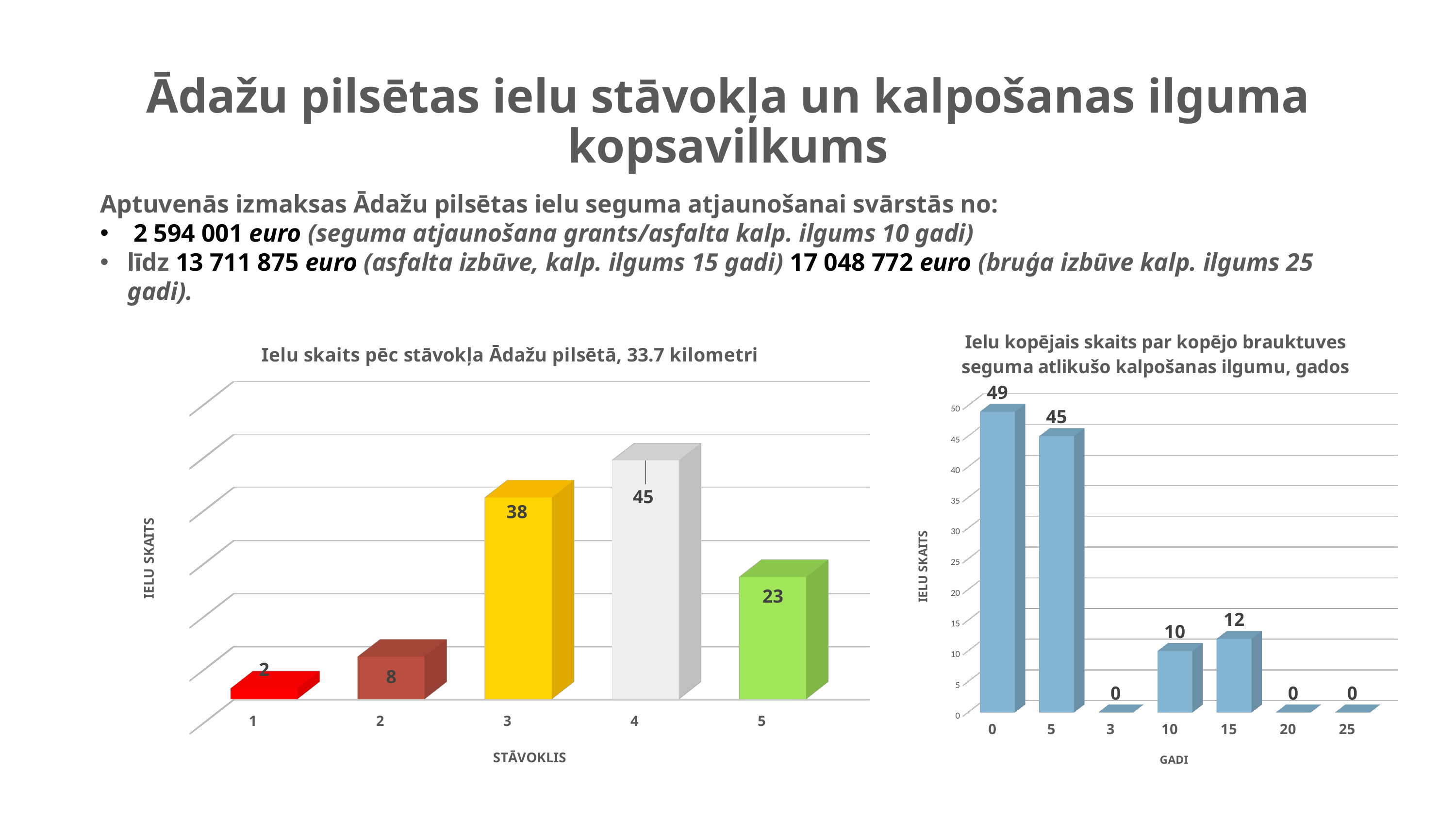
In the left chart (Ielu skaits pēc stāvokļa Ādažu pilsētā), which stāvoklis category has the lowest value? 1 In the left chart (Ielu skaits pēc stāvokļa Ādažu pilsētā), what is the difference between the values for stāvoklis 4 and stāvoklis 5? 22 In the left chart (Ielu skaits pēc stāvokļa Ādažu pilsētā), what is the value for stāvoklis 1? 2 In the left chart (Ielu skaits pēc stāvokļa Ādažu pilsētā), which stāvoklis category has the highest value? 4 In the left chart (Ielu skaits pēc stāvokļa Ādažu pilsētā), what is the value for stāvoklis 3? 38 In the right chart (Ielu kopējais skaits par kopējo brauktuves seguma atlikušo kalpošanas ilgumu), what is the difference between the values for 0 gadi and 5 gadi? 4 In the right chart (Ielu kopējais skaits par kopējo brauktuves seguma atlikušo kalpošanas ilgumu), how many gadi categories are shown on the x axis? 7 In the right chart (Ielu kopējais skaits par kopējo brauktuves seguma atlikušo kalpošanas ilgumu), which gadi category has the highest value? 0 In the left chart (Ielu skaits pēc stāvokļa Ādažu pilsētā), how many stāvoklis categories are shown? 5 In the right chart (Ielu kopējais skaits par kopējo brauktuves seguma atlikušo kalpošanas ilgumu), what is the value for 15 gadi? 12 In the right chart (Ielu kopējais skaits par kopējo brauktuves seguma atlikušo kalpošanas ilgumu), which is larger, the value for 10 gadi or the value for 15 gadi? 15 gadi What kind of chart is the left chart (Ielu skaits pēc stāvokļa Ādažu pilsētā)? bar chart